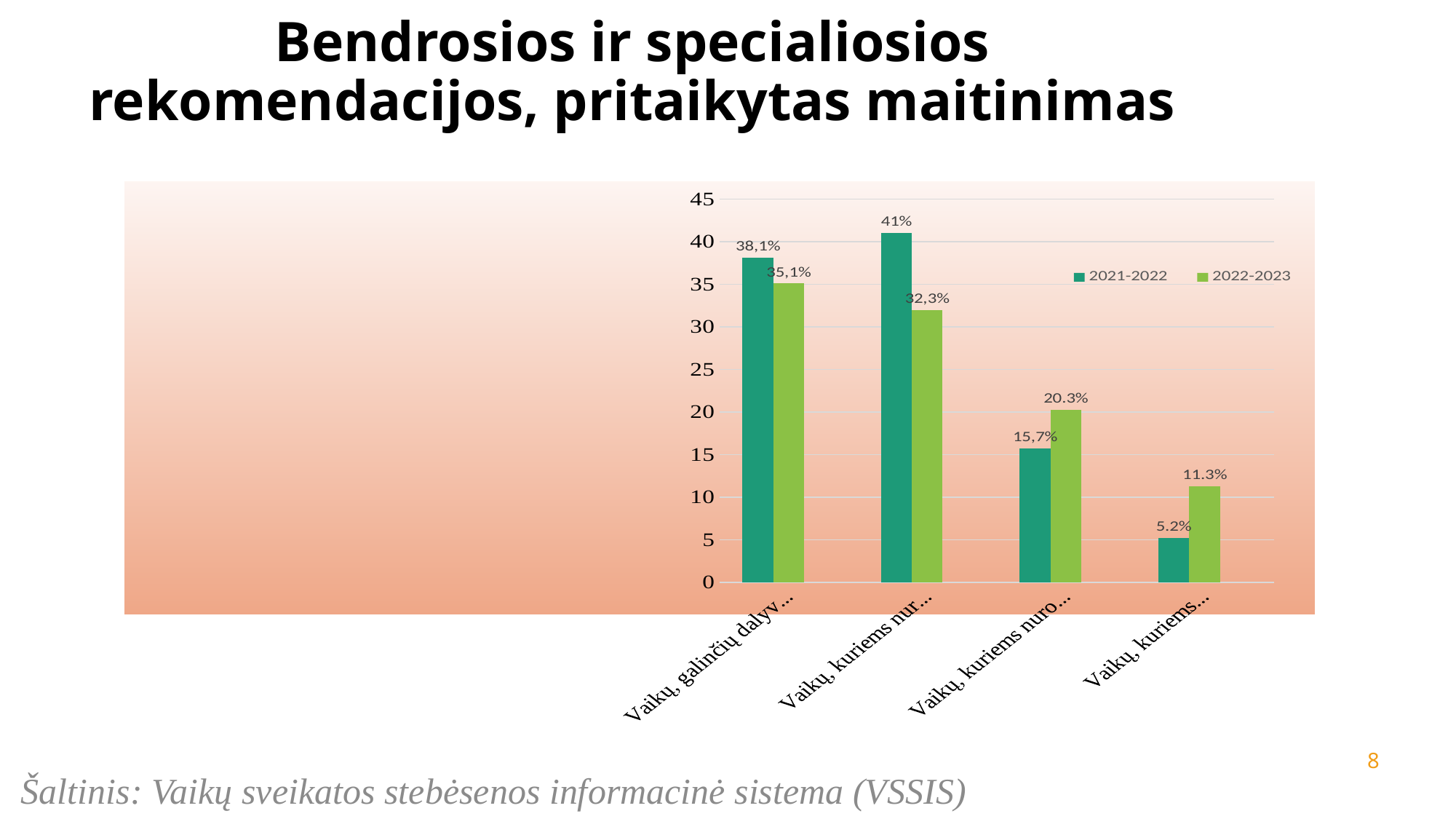
What is the 2022-2023 value for the second category group from the left? 32,3% What is the 2022-2023 value for the fourth (rightmost) category group? 11.3% What is the 2021-2022 value for the third category group from the left? 15,7% What is the 2021-2022 value for the first (leftmost) category group? 38,1% What type of chart is shown on the slide? Bar chart How many category groups are plotted on the x axis of the chart? 4 Which two series are listed in the chart legend? 2021-2022 and 2022-2023 In the third category group from the left, which series has the larger value, 2021-2022 or 2022-2023? 2022-2023 What is the lowest value shown on the chart? 5.2% How many series does the chart legend list? 2 What is the difference between the 2021-2022 and 2022-2023 values in the first (leftmost) category group? 3 percentage points Which category group has the highest 2021-2022 value? The second group from the left (41%)